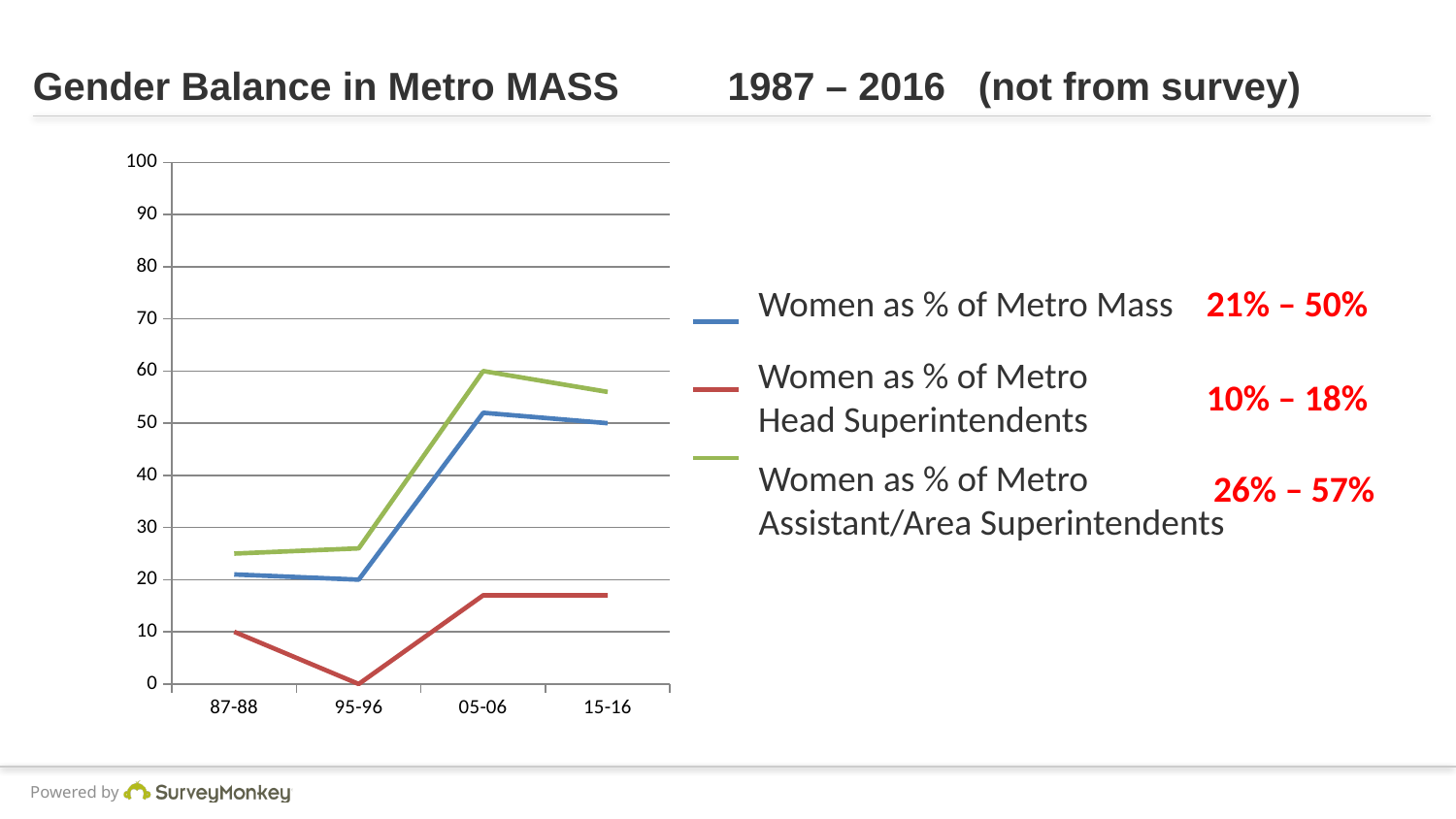
How many series does the chart's legend list? 3 Is the value for Women as % of Metro Assistant/Area Superintendents in 87-88 greater or less than 30? less In 87-88, which is larger: Women as % of Metro Mass or Women as % of Metro Head Superintendents? Women as % of Metro Mass What is the value for Women as % of Metro Head Superintendents in 95-96? 0 What range is printed in red next to the legend entry Women as % of Metro Mass? 21% – 50% What is the value for Women as % of Metro Assistant/Area Superintendents in 05-06? 60 Is the value for Women as % of Metro Mass in 05-06 greater or less than 40? greater Does the value for Women as % of Metro Head Superintendents rise or fall from 95-96 to 05-06? rise In which period is the value for Women as % of Metro Head Superintendents lowest? 95-96 Which series has the highest value in 15-16? Women as % of Metro Assistant/Area Superintendents How many time periods are shown on the x axis of the chart? 4 What kind of chart is shown on the slide? line chart